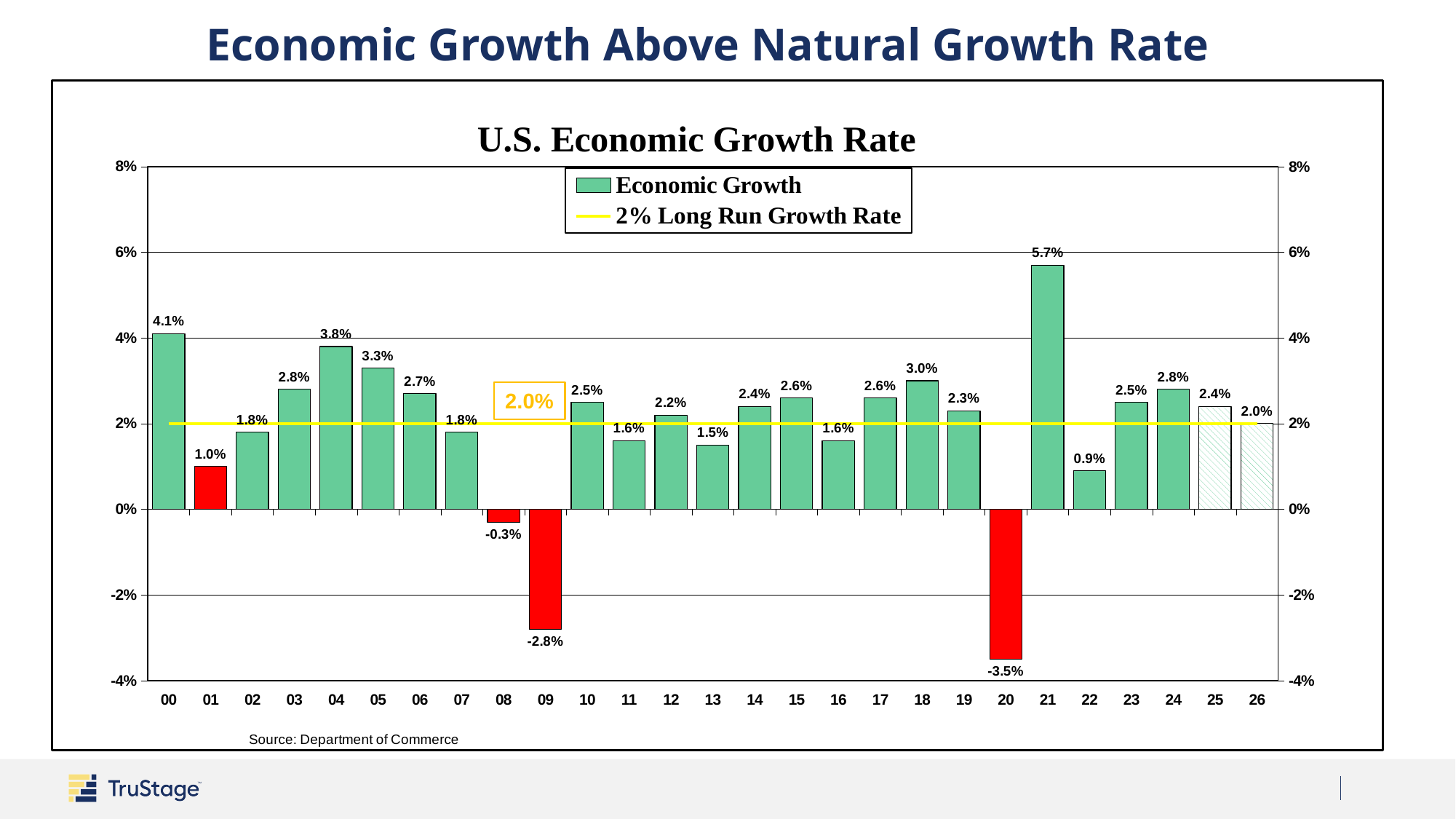
How many entries does the legend list? 2 Is the economic growth rate for 00 greater or less than 4%? greater What is the economic growth rate shown for 25? 2.4% What is the economic growth rate shown for 09? -2.8% Which year has the lowest economic growth rate? 20 How many years are shown on the x axis? 27 What is the title of the chart? U.S. Economic Growth Rate Which year has the highest economic growth rate? 21 What is the difference between the economic growth rate in 21 and in 22? 4.8% What kind of chart is used to show the economic growth rate? bar chart What is the economic growth rate shown for 21? 5.7% Which year has a higher economic growth rate, 04 or 18? 04